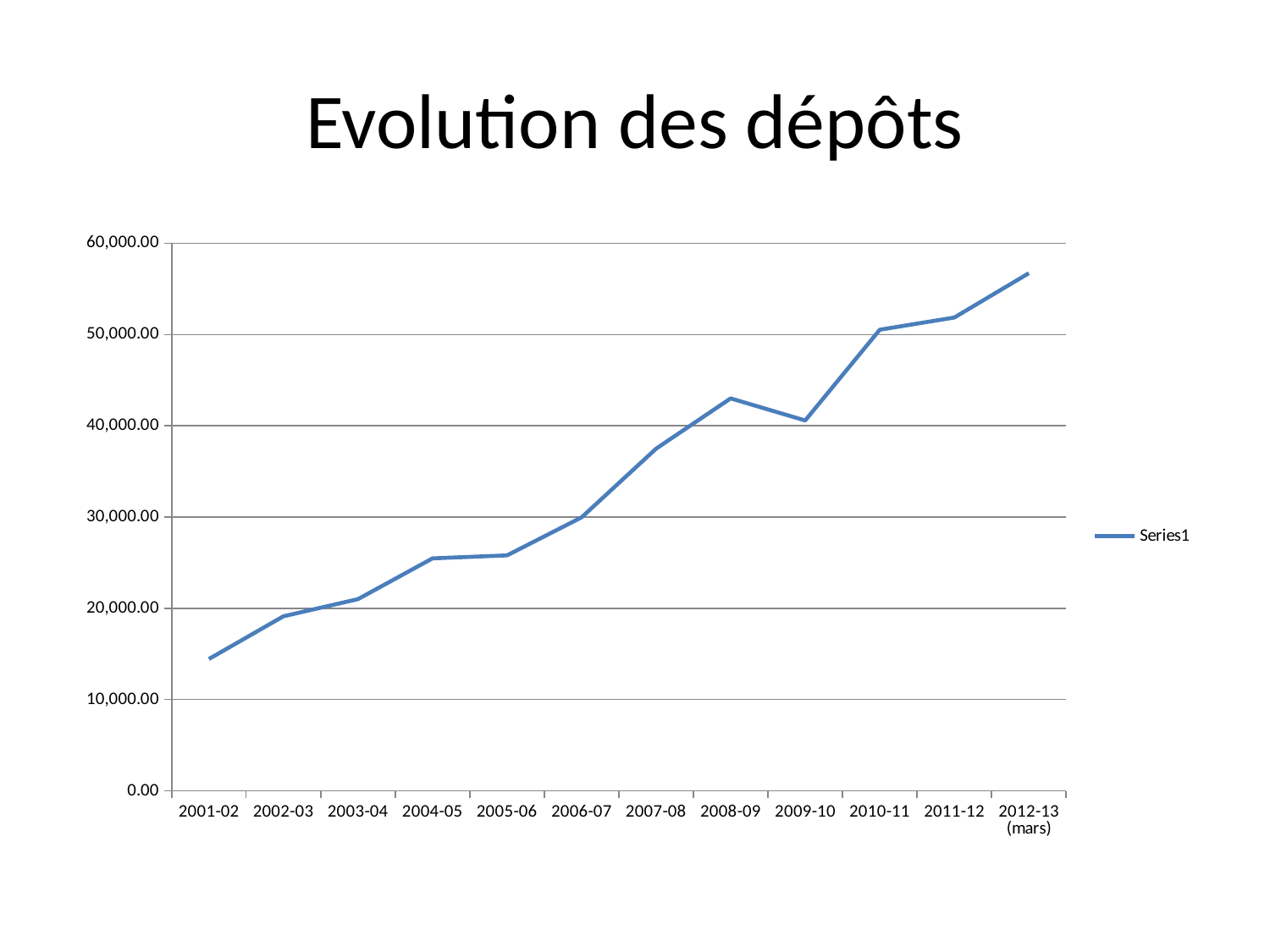
How many points are plotted along the x axis? 12 What kind of chart is shown on the slide? line chart Which period has the lowest value? 2001-02 Is the value for 2012-13 (mars) greater or less than 50,000.00? greater How many series does the legend list? 1 Is the value for 2001-02 greater or less than 20,000.00? less Is the value for 2007-08 greater or less than 40,000.00? less Which is larger, the value for 2008-09 or the value for 2009-10? 2008-09 What is the title of the chart? Evolution des dépôts Do the values generally rise or fall from 2001-02 to 2012-13 (mars)? rise Which period has the highest value? 2012-13 (mars)